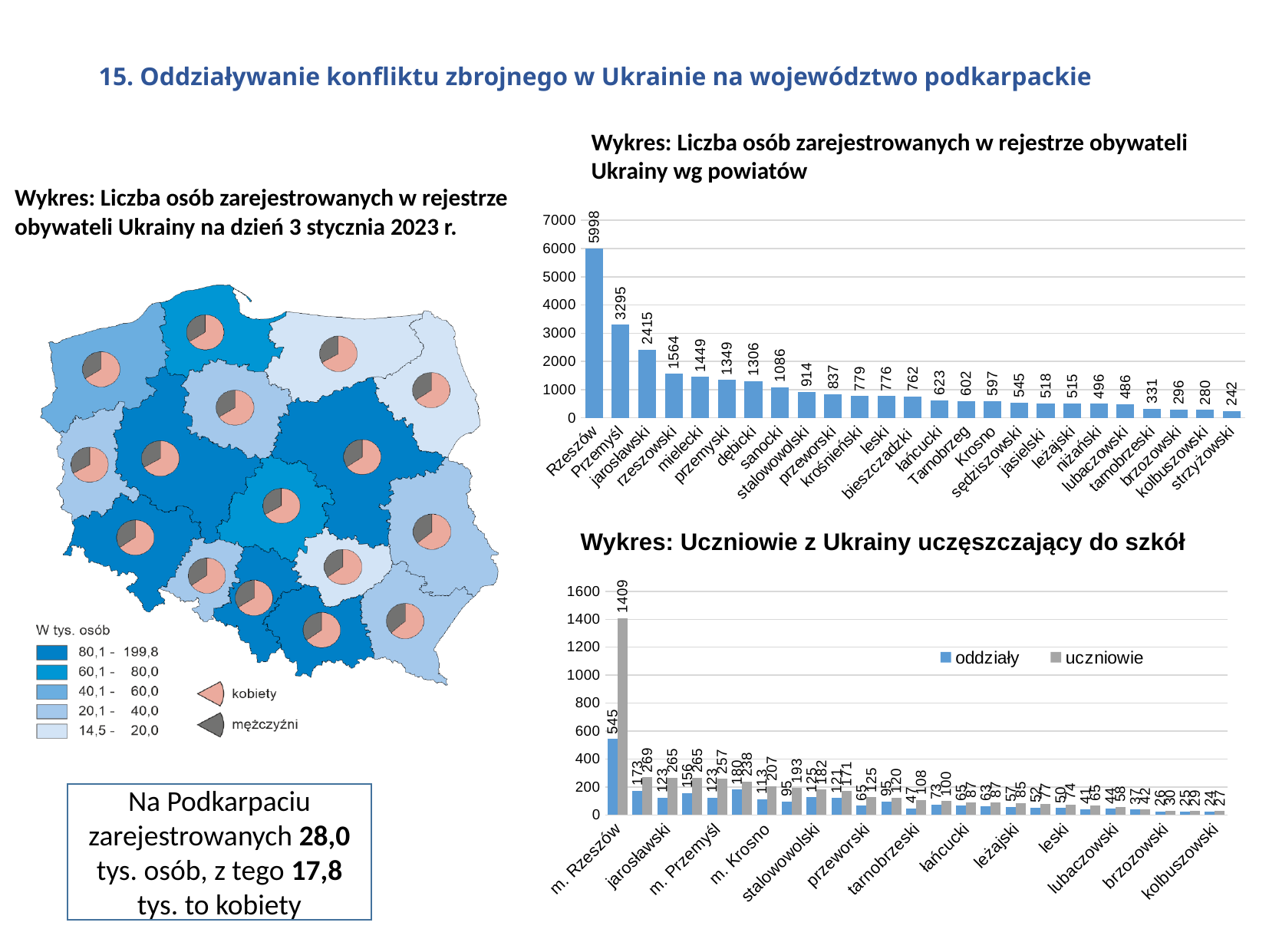
In the chart 'Liczba osób zarejestrowanych w rejestrze obywateli Ukrainy wg powiatów', which powiat has the lowest value? strzyżowski In the chart 'Liczba osób zarejestrowanych w rejestrze obywateli Ukrainy wg powiatów', what is the difference between Rzeszów and Przemyśl? 2703 In the chart 'Liczba osób zarejestrowanych w rejestrze obywateli Ukrainy wg powiatów', what is the value for Rzeszów? 5998 In the chart 'Liczba osób zarejestrowanych w rejestrze obywateli Ukrainy wg powiatów', what is the value for jarosławski? 2415 In the chart 'Uczniowie z Ukrainy uczęszczający do szkół', what is the difference between uczniowie and oddziały for m. Rzeszów? 864 What kind of chart is 'Uczniowie z Ukrainy uczęszczający do szkół'? bar chart In the chart 'Liczba osób zarejestrowanych w rejestrze obywateli Ukrainy wg powiatów', do the values rise or fall from left to right? fall In the chart 'Uczniowie z Ukrainy uczęszczający do szkół', what is the value of uczniowie for m. Rzeszów? 1409 In the chart 'Uczniowie z Ukrainy uczęszczający do szkół', what is the value of oddziały for m. Krosno? 113 In the chart 'Uczniowie z Ukrainy uczęszczający do szkół', how many series does the legend list? 2 In the chart 'Liczba osób zarejestrowanych w rejestrze obywateli Ukrainy wg powiatów', how many powiats are shown? 25 In the chart 'Liczba osób zarejestrowanych w rejestrze obywateli Ukrainy wg powiatów', which is larger: mielecki or dębicki? mielecki